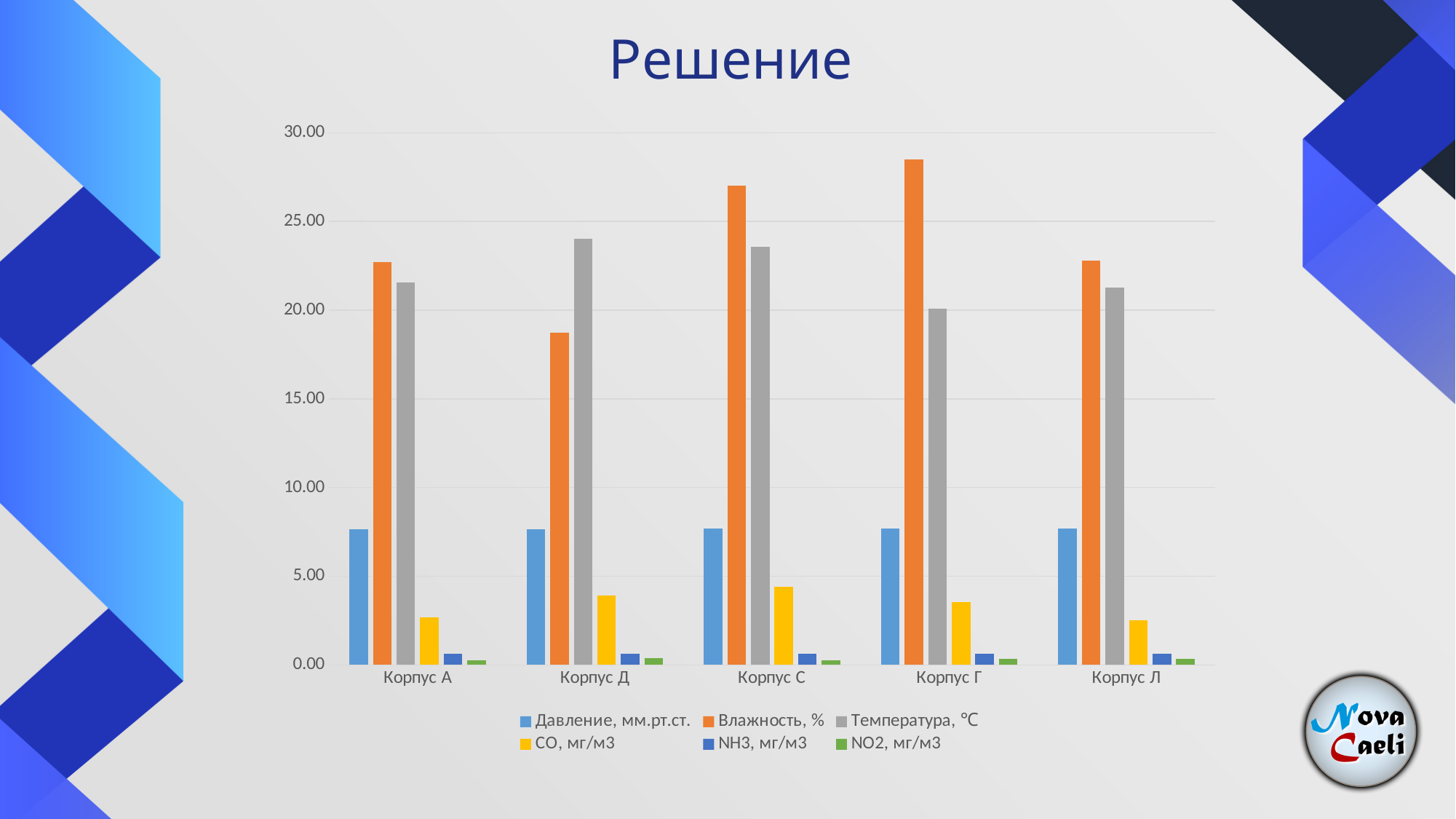
In Корпус Д, which is larger: Влажность, % or Температура, °C? Температура, °C What kind of chart is shown on the slide? bar chart Which корпус has the highest value for Влажность, %? Корпус Г Is the value of CO, мг/м3 for Корпус С greater or less than 5.00? less Which корпус has the lowest value for Влажность, %? Корпус Д Is the value of Влажность, % for Корпус Д greater or less than 20.00? less Which is larger: Влажность, % for Корпус С or for Корпус А? Корпус С How many categories (корпуса) are shown on the x axis? 5 Which корпус has the lowest value for Температура, °C? Корпус Г What is the title of the slide containing the chart? Решение How many series does the legend list? 6 Is the value of Влажность, % for Корпус Г greater or less than 25.00? greater